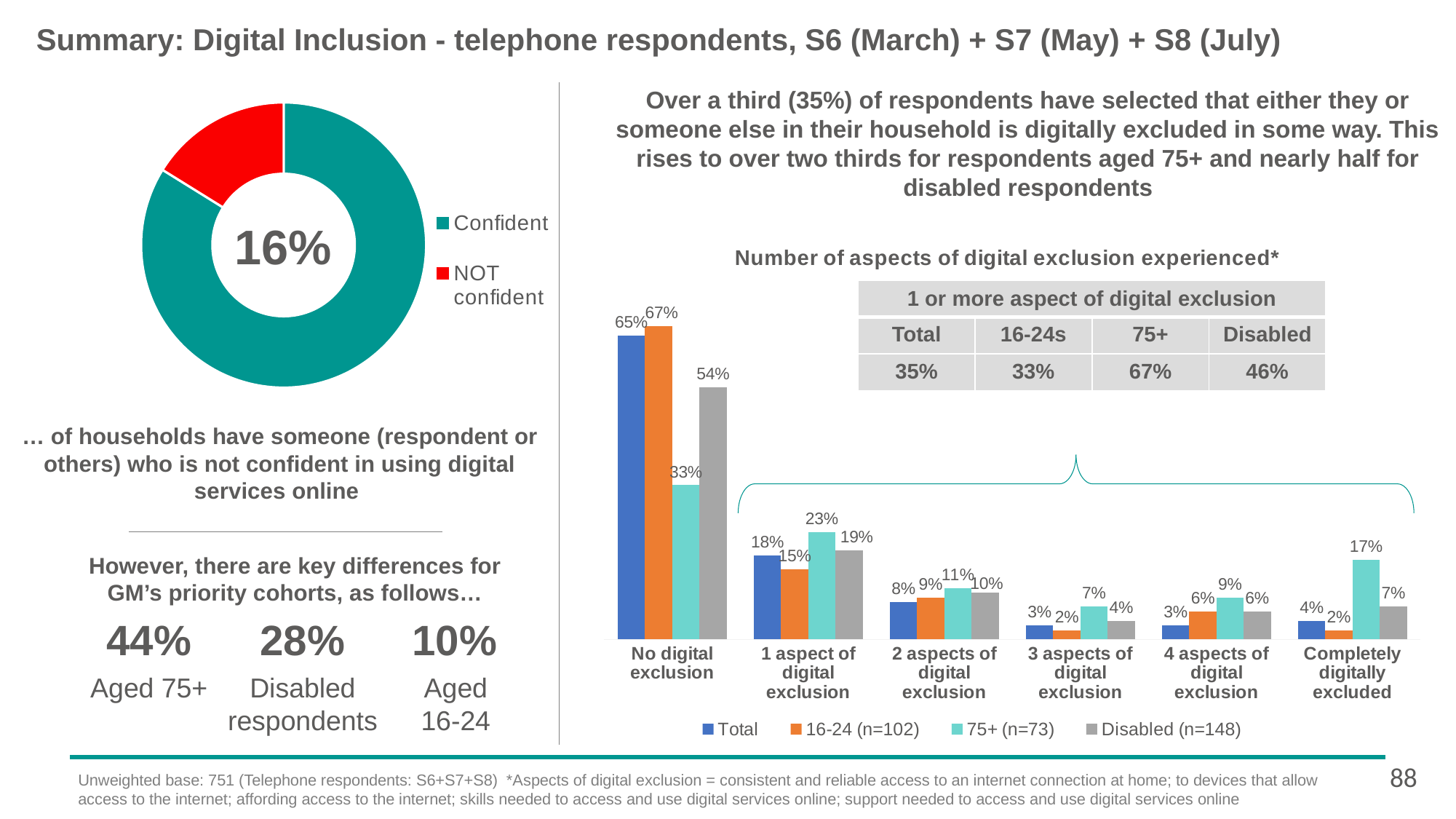
In the doughnut chart on the left, what share is labelled as NOT confident? 16% What kind of chart is the chart on the left of the slide? Doughnut (pie) chart How many categories are shown on the x axis of the 'Number of aspects of digital exclusion experienced*' chart? 6 What is the title of the bar chart on the right of the slide? Number of aspects of digital exclusion experienced* In the 'Number of aspects of digital exclusion experienced*' chart, which is larger for '2 aspects of digital exclusion': Total or Disabled (n=148)? Disabled (n=148) In the 'Number of aspects of digital exclusion experienced*' chart, what is the value for 75+ (n=73) in the 'Completely digitally excluded' category? 17% In the 'Number of aspects of digital exclusion experienced*' chart, which series has the highest value for '1 aspect of digital exclusion'? 75+ (n=73) In the 'Number of aspects of digital exclusion experienced*' chart, what is the Total value for 'No digital exclusion'? 65% How many series does the legend of the 'Number of aspects of digital exclusion experienced*' chart list? 4 In the 'Number of aspects of digital exclusion experienced*' chart, which series has the lowest value for 'Completely digitally excluded'? 16-24 (n=102) In the 'Number of aspects of digital exclusion experienced*' chart, does the Total series generally rise or fall from 'No digital exclusion' to '4 aspects of digital exclusion'? Fall In the 'Number of aspects of digital exclusion experienced*' chart, what is the difference between the 16-24 (n=102) and 75+ (n=73) values for 'No digital exclusion'? 34 percentage points